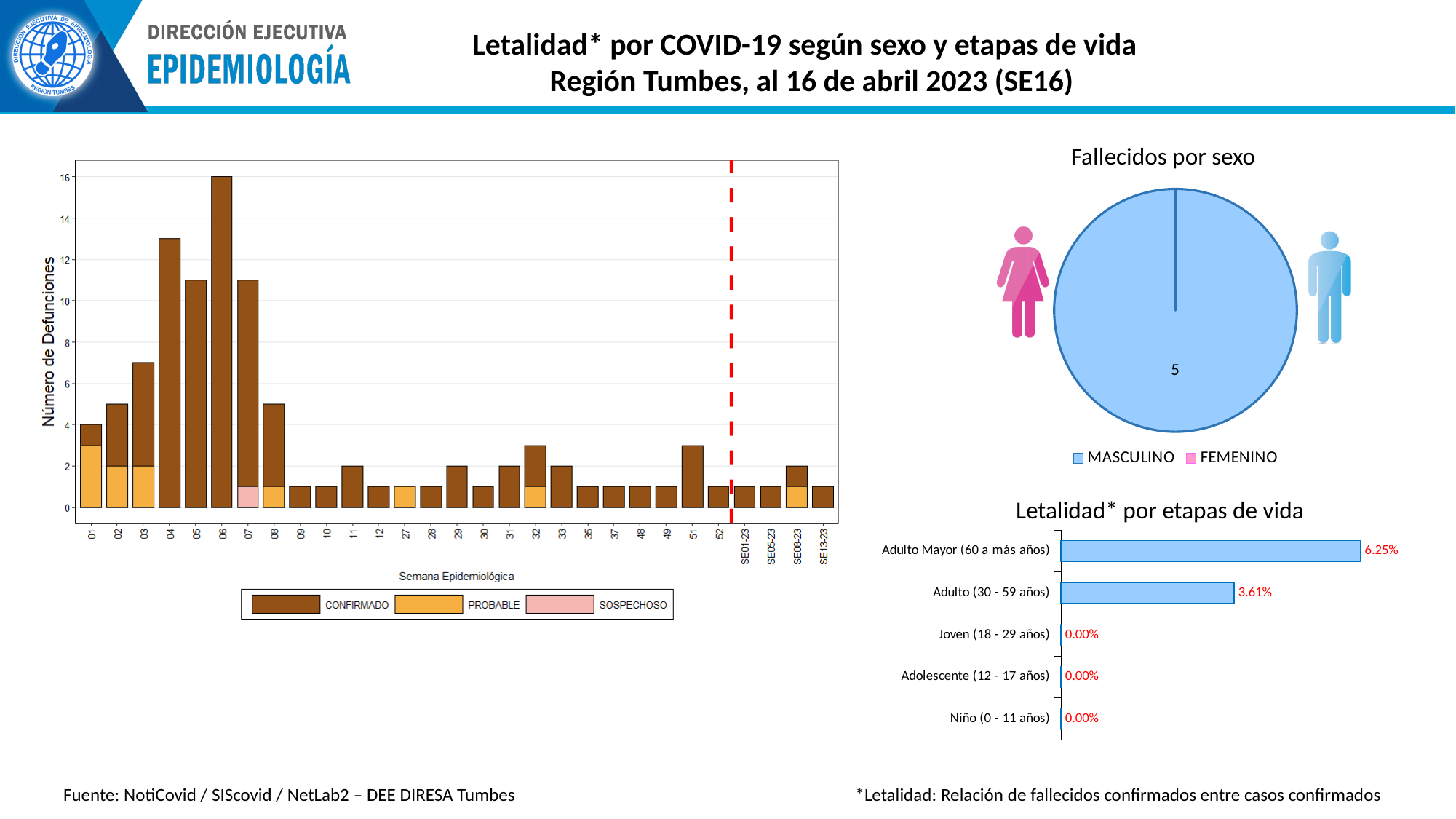
In the left bar chart of deaths by epidemiological week, which week has the highest number of deaths? 06 In the 'Letalidad* por etapas de vida' chart, what is the difference between the values for Adulto Mayor (60 a más años) and Adulto (30 - 59 años)? 2.64% In the 'Letalidad* por etapas de vida' chart, what is the value for Adulto Mayor (60 a más años)? 6.25% In the 'Fallecidos por sexo' chart, what kind of chart is it? pie chart In the 'Fallecidos por sexo' chart, what is the value shown for MASCULINO? 5 In the left bar chart of deaths by epidemiological week, which series is shown in pink? SOSPECHOSO In the 'Letalidad* por etapas de vida' chart, what is the value for Adulto (30 - 59 años)? 3.61% In the 'Letalidad* por etapas de vida' chart, how many age-group categories are shown? 5 In the left bar chart of deaths by epidemiological week, what is the total number of deaths in week 06? 16 In the left bar chart of deaths by epidemiological week, is the total for week 04 greater or less than 12? greater In the left bar chart of deaths by epidemiological week, which week has more deaths, week 04 or week 05? 04 In the left bar chart of deaths by epidemiological week, how many series does the legend list? 3